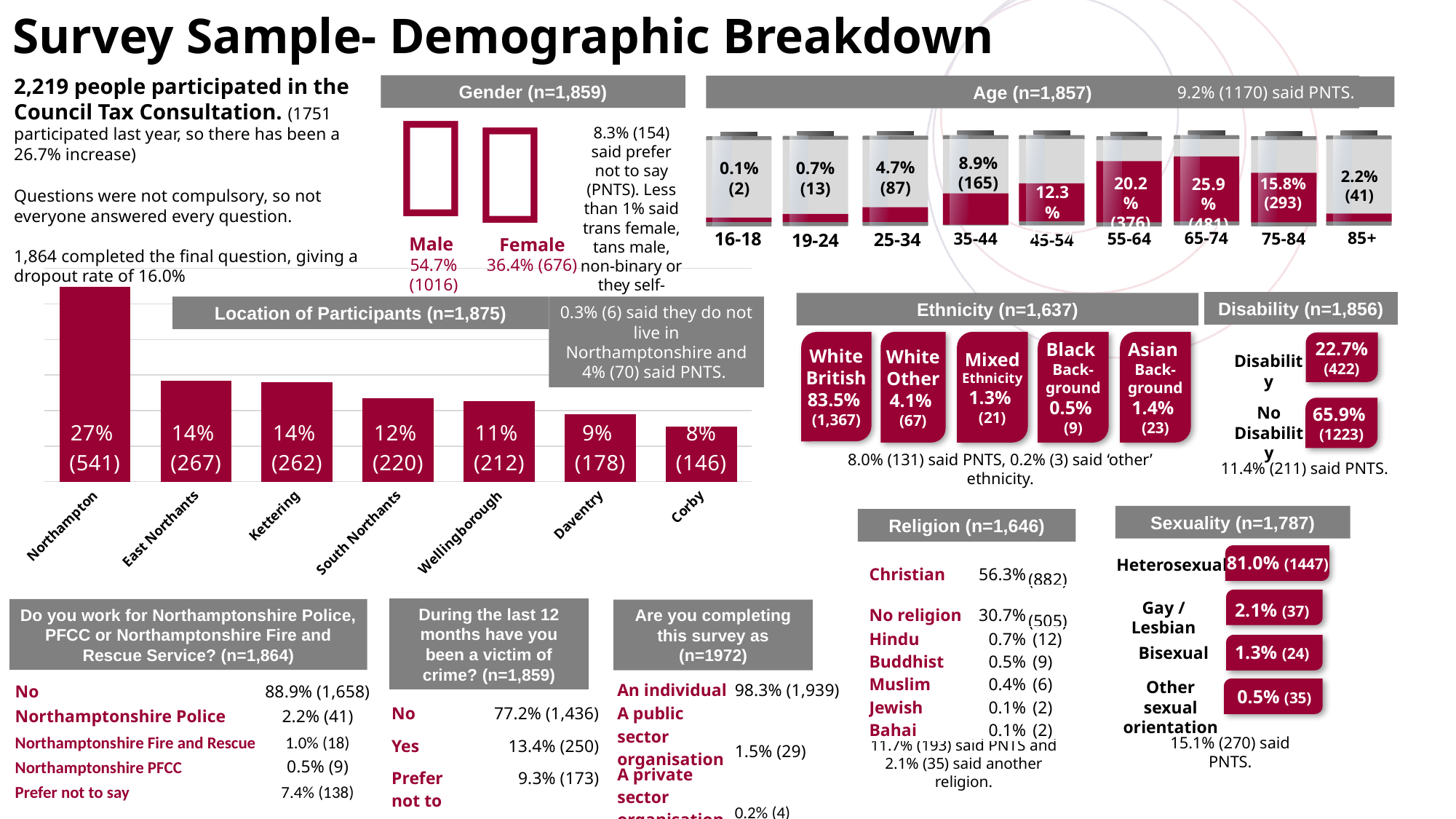
In the Location of Participants chart, what percentage of participants were from Northampton? 27% In the Location of Participants chart, how many more participants were from Northampton than from Corby? 395 In the Location of Participants chart, which has more participants, Daventry or Wellingborough? Wellingborough What is the title of the bar chart on the slide? Location of Participants (n=1,875) What kind of chart is the Location of Participants chart? Bar chart How many locations are shown in the Location of Participants chart? 7 In the Location of Participants chart, how many participants were from Corby? 146 In the Location of Participants chart, do the values rise or fall from left to right? Fall In the Location of Participants chart, which location has the highest number of participants? Northampton In the Location of Participants chart, what value is shown for South Northants? 12% (220) In the Location of Participants chart, what is the difference in participant numbers between East Northants and Kettering? 5 In the Location of Participants chart, which location has the lowest number of participants? Corby